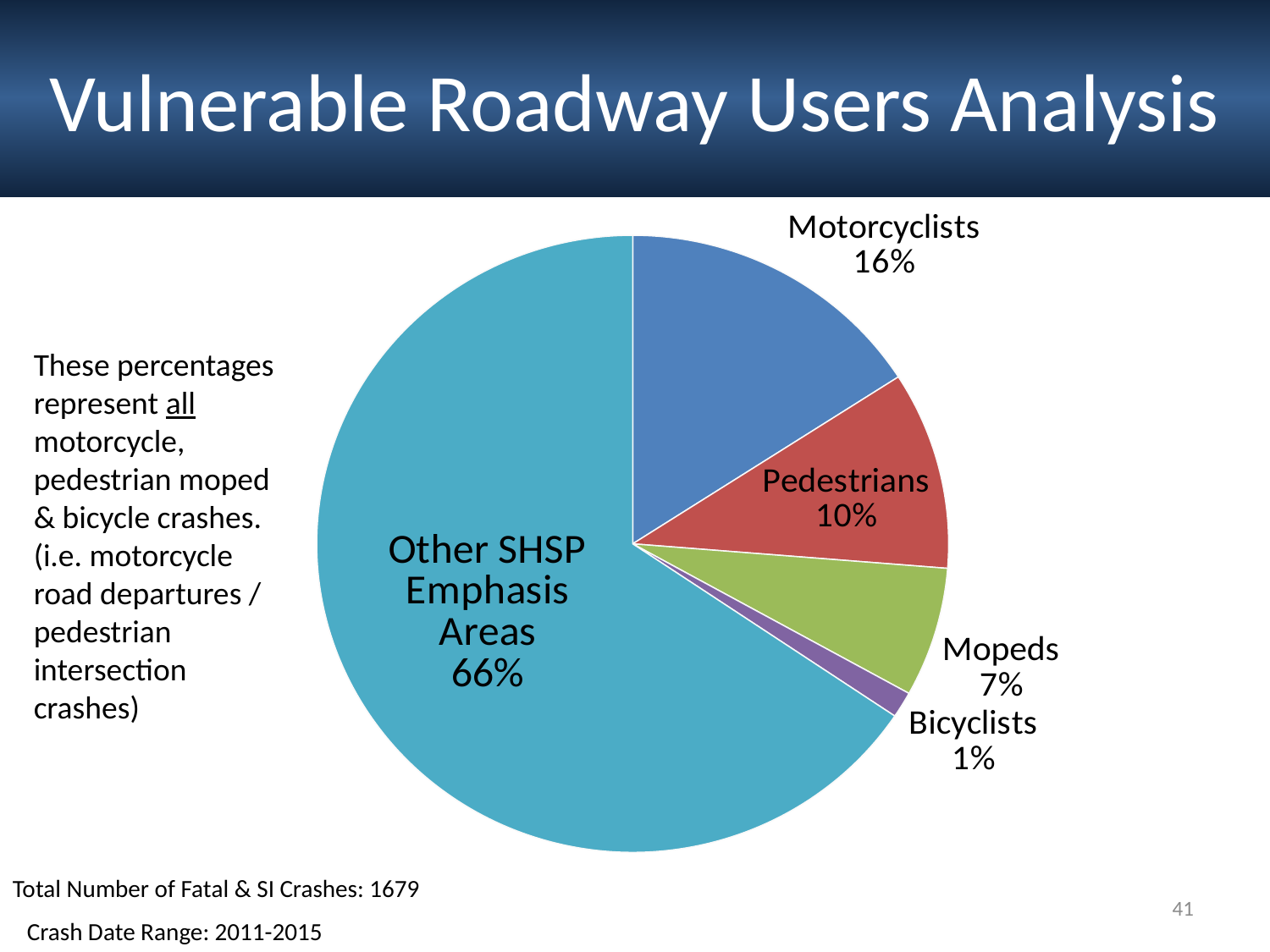
What percentage of the pie chart is Bicyclists? 1% What percentage of the pie chart is Motorcyclists? 16% How many slices does the pie chart have? 5 What is the difference in percentage points between Motorcyclists and Pedestrians? 6 Which slice of the pie chart is the smallest? Bicyclists What percentage of the pie chart is Mopeds? 7% Which slice of the pie chart is the largest? Other SHSP Emphasis Areas Which is larger, the Mopeds slice or the Pedestrians slice? Pedestrians What percentage of the pie chart is Other SHSP Emphasis Areas? 66% What colour is the Other SHSP Emphasis Areas slice? Teal What percentage of the pie chart is Pedestrians? 10% What kind of chart is shown on the slide? Pie chart